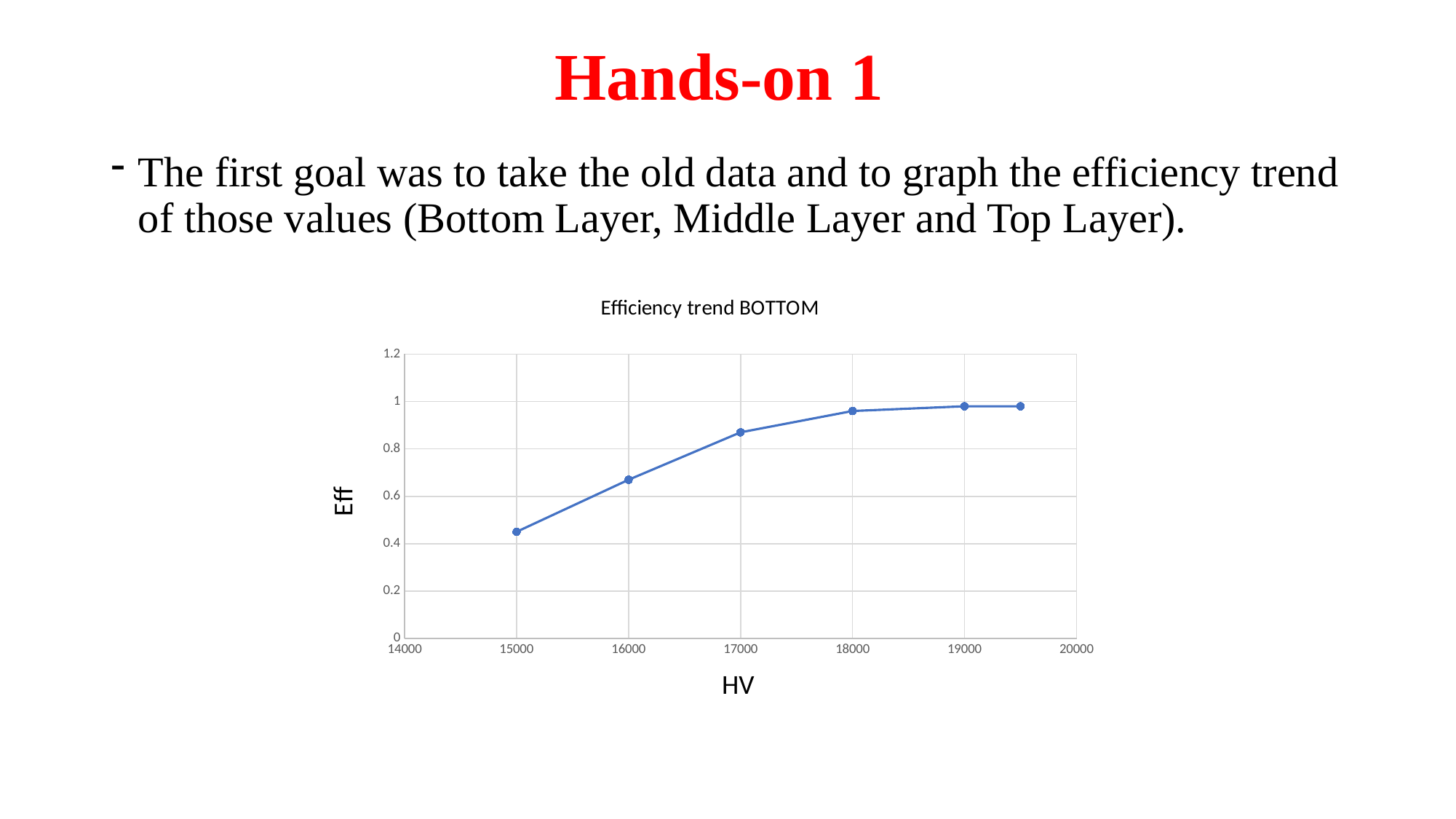
What are the labels of the x axis and y axis of the chart? HV and Eff How many data points are plotted on the chart? 6 Which has the larger Eff value, HV 15000 or HV 17000? 17000 Is the Eff value at HV 15000 greater or less than 0.6? less Which has the larger Eff value, HV 16000 or HV 18000? 18000 Is the Eff value at HV 17000 greater or less than 0.8? greater Is the Eff value at HV 18000 greater or less than 1? less What is the title of the chart? Efficiency trend BOTTOM Do the Eff values rise or fall as HV increases along the x axis? rise What kind of chart is shown on the slide? line chart At which HV value is the Eff lowest? 15000